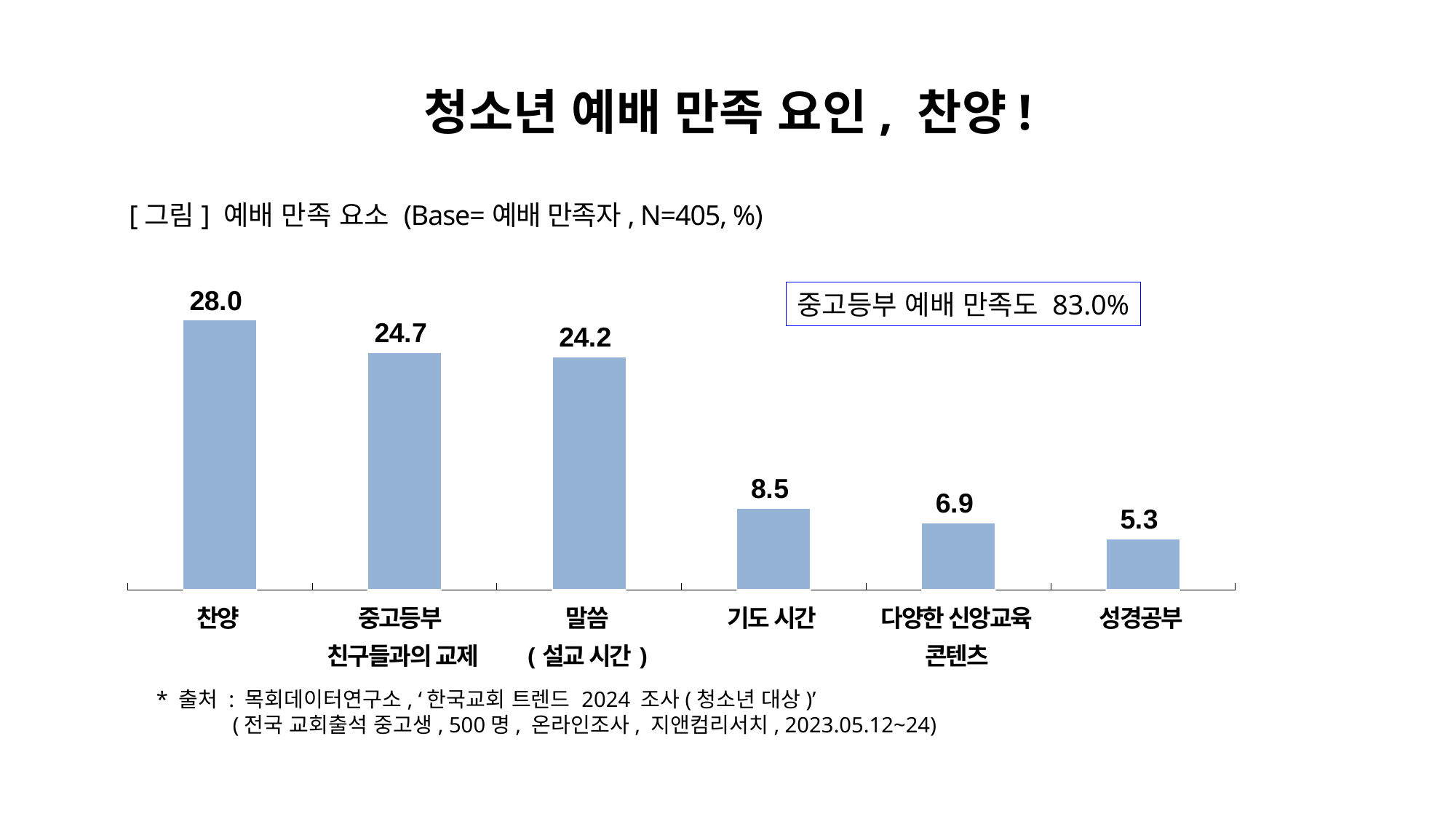
What is the value for 찬양? 28.0 How many categories are shown in the chart? 6 What is the 중고등부 예배 만족도 figure shown in the box on the chart? 83.0% Which category has the lowest value? 성경공부 What is the value for 다양한 신앙교육 콘텐츠? 6.9 Which is larger, the value for 중고등부 친구들과의 교제 or the value for 기도 시간? 중고등부 친구들과의 교제 What kind of chart is shown on the slide? bar chart Which category has the highest value? 찬양 What is the value for 기도 시간? 8.5 What is the difference between the values for 찬양 and 말씀 (설교 시간)? 3.8 What is the value for 성경공부? 5.3 What is the difference between the values for 기도 시간 and 성경공부? 3.2